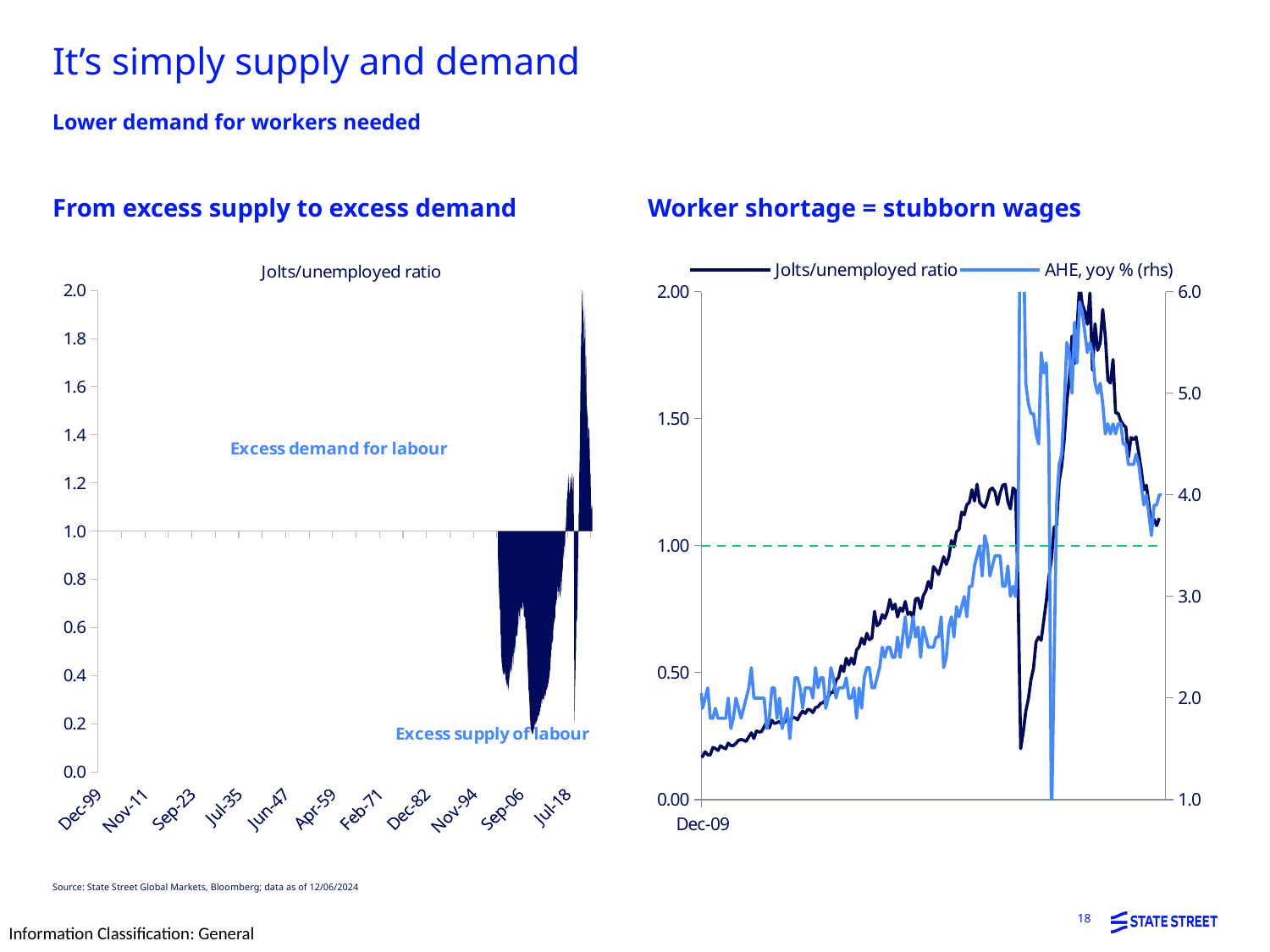
In the 'Worker shortage = stubborn wages' chart, is the AHE, yoy % (rhs) value at the start of the series greater or less than 3.0 on the right-hand axis? less In the 'Worker shortage = stubborn wages' chart, is the Jolts/unemployed ratio at the start of the series (Dec-09) greater or less than 0.50? less What is the title printed above the plot area of the 'From excess supply to excess demand' chart on the left? Jolts/unemployed ratio In the 'From excess supply to excess demand' chart on the left, is the highest point of the shaded area greater or less than 1.8? greater What are the two series named in the legend of the 'Worker shortage = stubborn wages' chart? Jolts/unemployed ratio and AHE, yoy % (rhs) How many series does the legend of the 'Worker shortage = stubborn wages' chart list? 2 How many date labels are shown along the x axis of the 'From excess supply to excess demand' chart on the left? 11 In the 'Worker shortage = stubborn wages' chart, does the Jolts/unemployed ratio rise or fall from the start of the series to its end? rise What kind of chart is the 'Worker shortage = stubborn wages' chart on the right? line chart